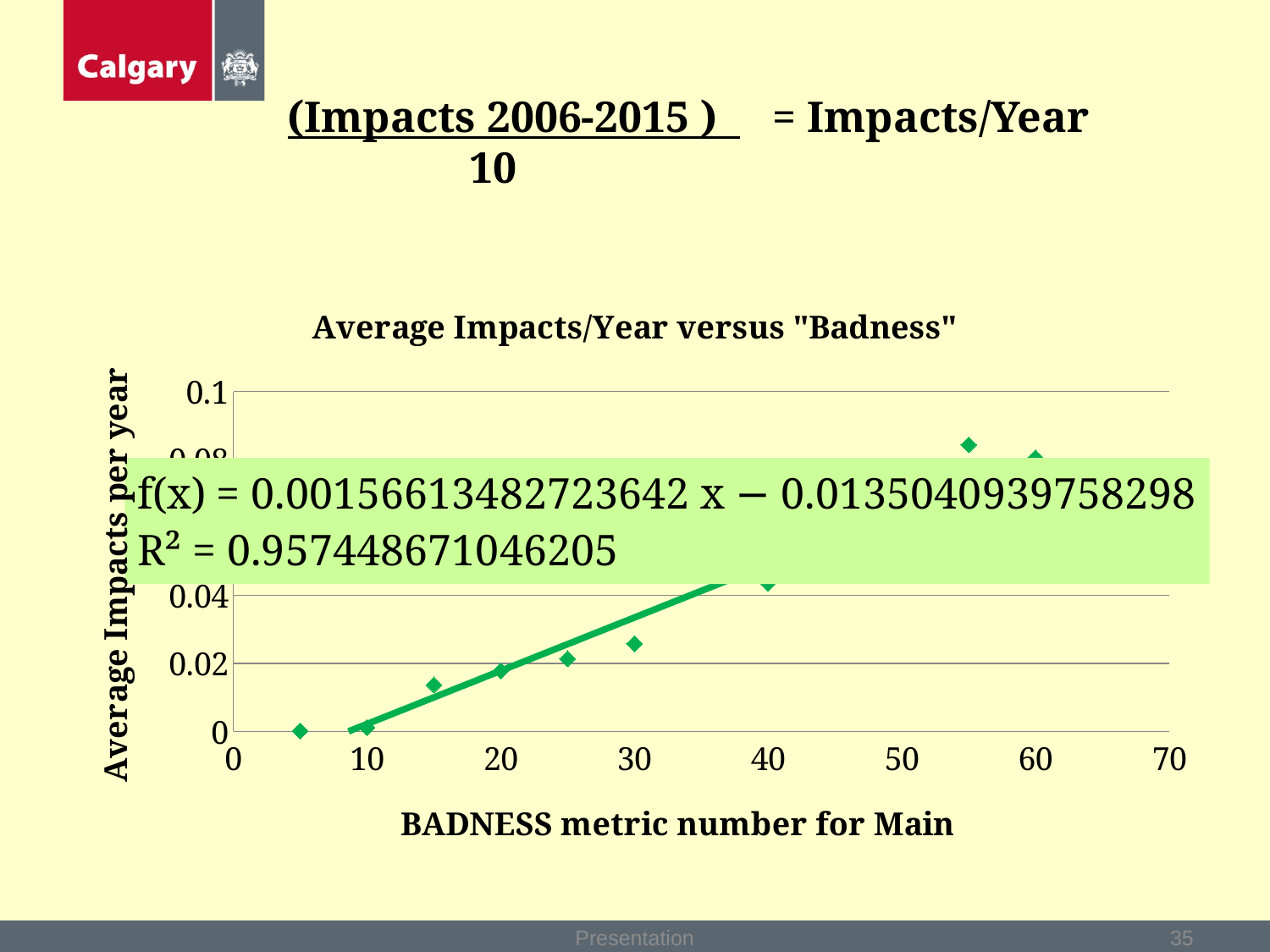
Which has the larger average impacts per year: a BADNESS metric number of 55 or 30? 55 What is the highest value shown on the y axis of the chart? 0.1 Do the plotted values generally rise or fall as the BADNESS metric number increases? rise What is the highest value shown on the x axis of the chart? 70 Is the value for a BADNESS metric number of 30 greater or less than 0.04? less What is the label of the x axis of the chart? BADNESS metric number for Main Which has the larger average impacts per year: a BADNESS metric number of 40 or 15? 40 Is the value for a BADNESS metric number of 55 greater or less than 0.06? greater Is the value for a BADNESS metric number of 60 greater or less than 0.06? greater What is the title of the chart? Average Impacts/Year versus "Badness" What kind of chart is shown on the slide? scatter chart